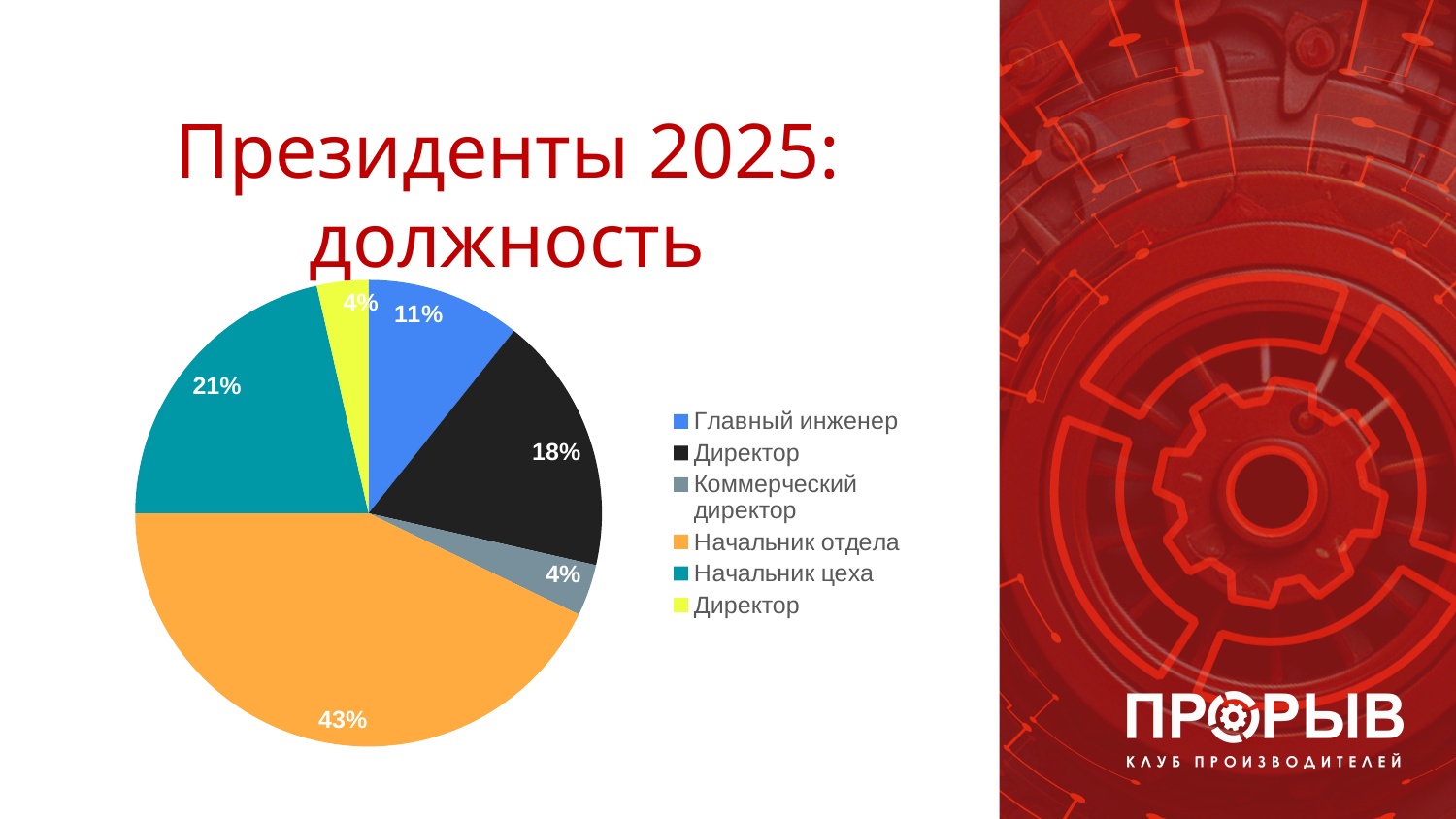
What is the difference in percentage points between Главный инженер and Коммерческий директор? 7 Which is larger, the slice for Начальник цеха or the slice for Главный инженер? Начальник цеха What is the title of the slide containing the chart? Президенты 2025: должность How many slices does the pie chart have? 6 How many entries does the legend list? 6 What share of the pie does Коммерческий директор have? 4% What is the difference in percentage points between Начальник отдела and Начальник цеха? 22 Which category has the largest slice of the pie? Начальник отдела What kind of chart is shown on the slide? pie chart What share of the pie does Главный инженер have? 11% What share of the pie does Начальник отдела have? 43% What share of the pie does Начальник цеха have? 21%